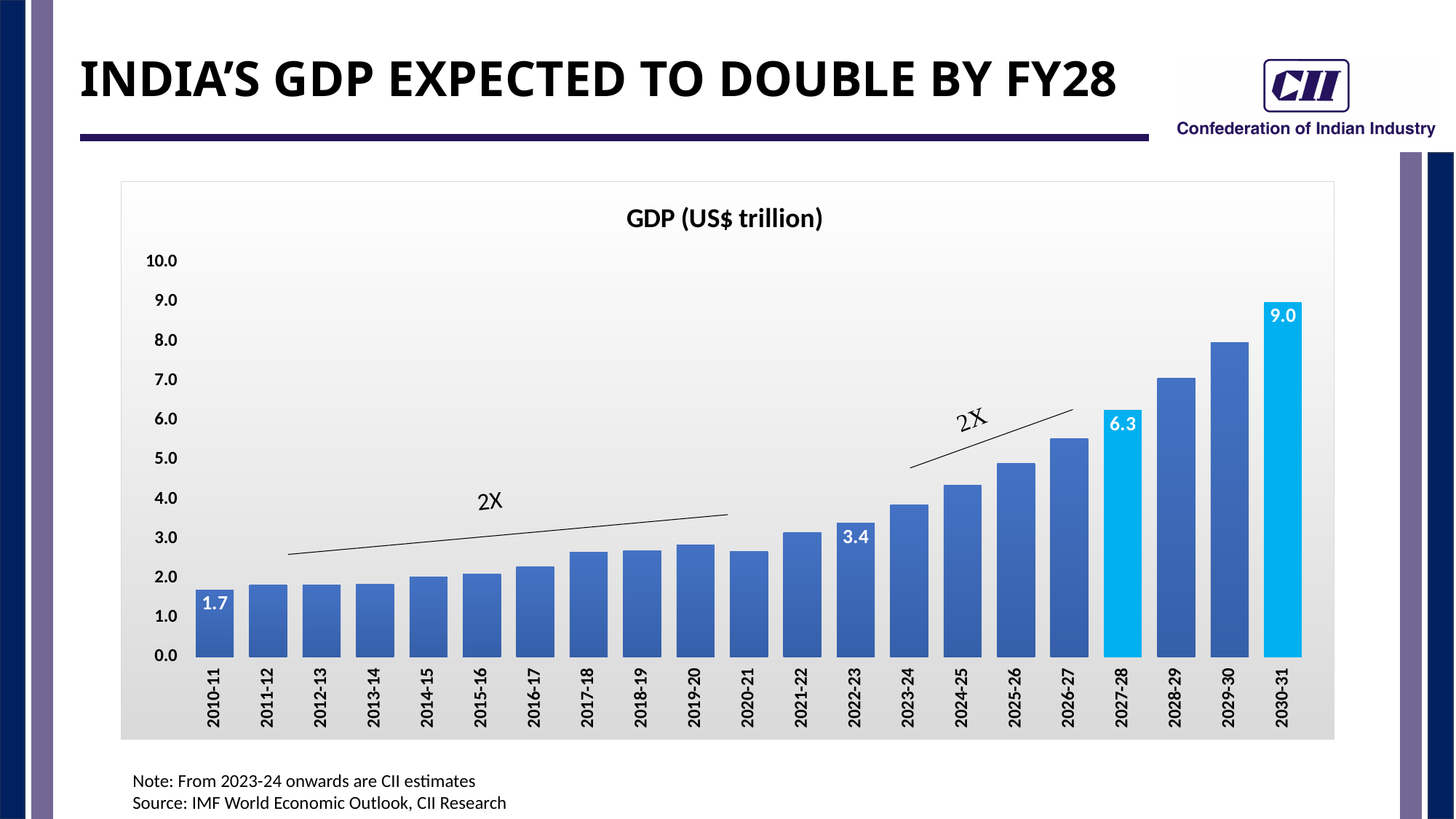
What is the GDP value shown for 2030-31? 9.0 How many years (bars) are shown in the chart? 21 Which year has the lowest GDP value in the chart? 2010-11 What is the difference between the GDP values for 2030-31 and 2010-11? 7.3 Which year has the highest GDP value in the chart? 2030-31 Do the GDP values generally rise or fall from 2010-11 to 2030-31? rise What is the GDP value shown for 2010-11? 1.7 What is the GDP value shown for 2022-23? 3.4 Is the GDP value for 2019-20 greater or less than 3.0? less What is the GDP value shown for 2027-28? 6.3 Is the GDP value for 2026-27 greater or less than 5.0? greater What is the difference between the GDP values for 2027-28 and 2022-23? 2.9